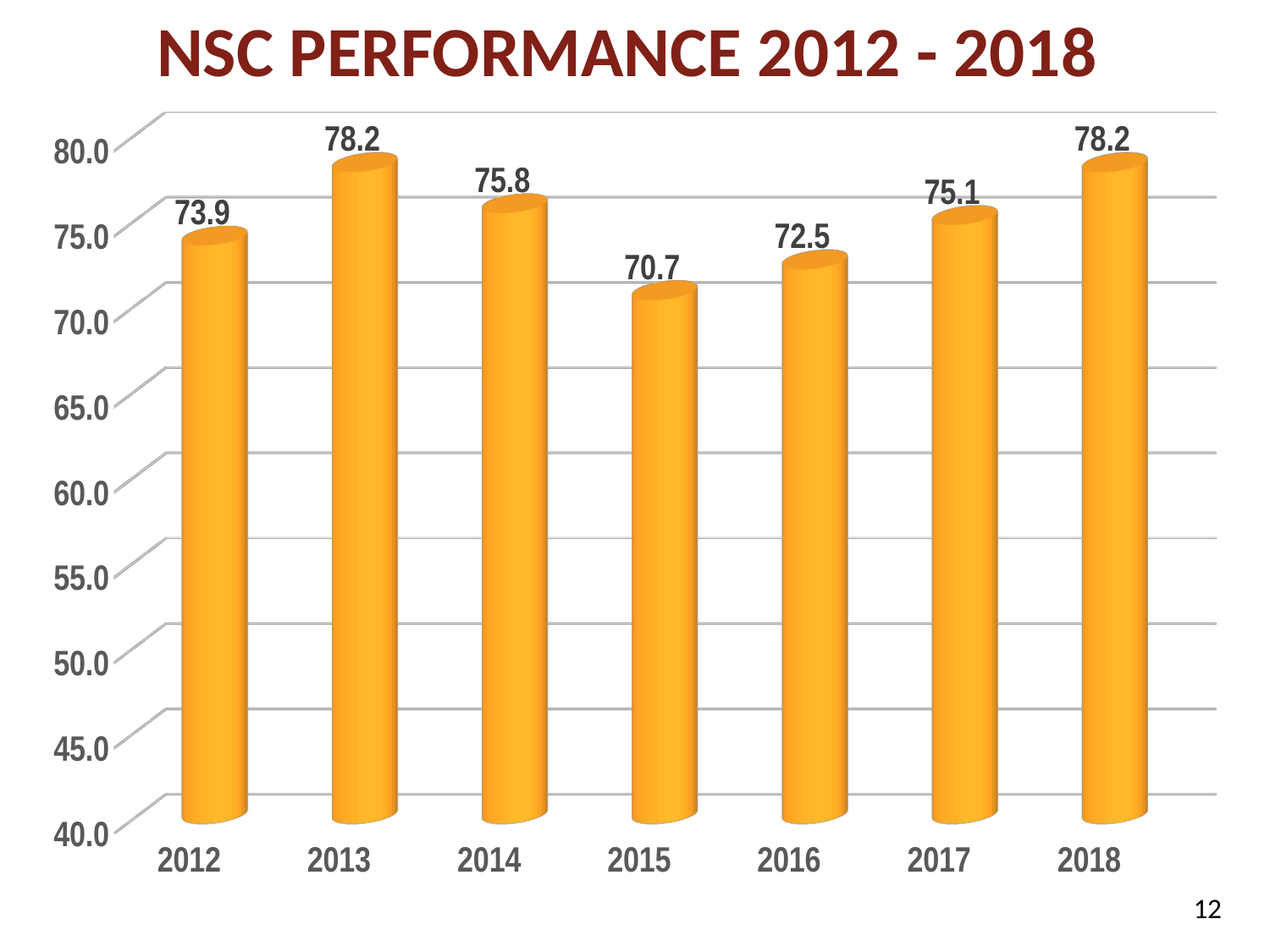
What is the title of the chart? NSC PERFORMANCE 2012 - 2018 Is the value for 2016 greater or less than 75.0? less Which is larger, the value for 2014 or the value for 2016? 2014 How many years are shown on the chart? 7 What is the value for 2015? 70.7 What is the highest value shown on the chart? 78.2 Which year has the lowest value? 2015 What is the difference between the values for 2018 and 2017? 3.1 What is the value for 2017? 75.1 What kind of chart is this? bar chart What is the difference between the values for 2013 and 2015? 7.5 What is the value for 2012? 73.9